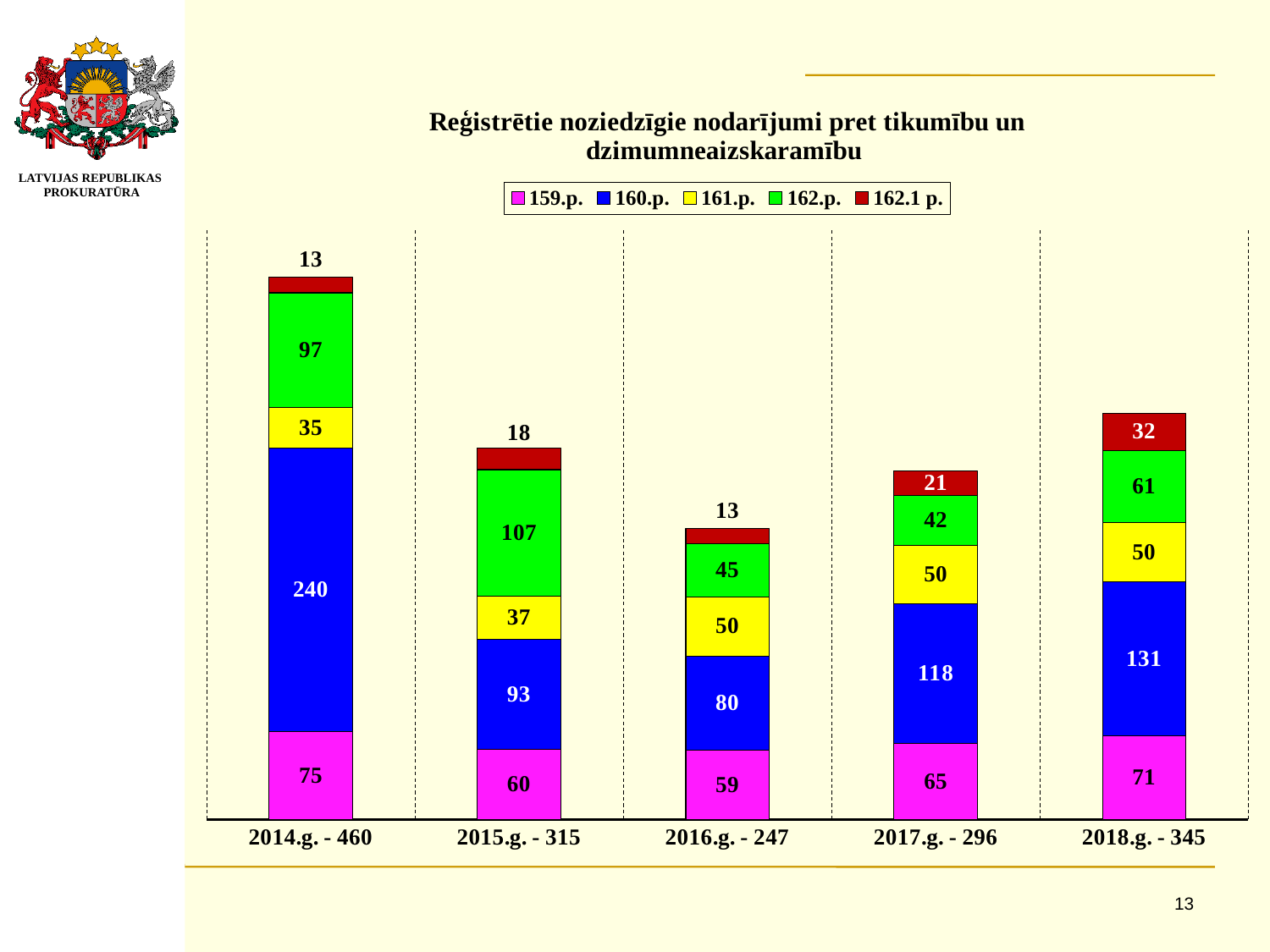
What is the value for 162.p. in 2015? 107 What type of chart is shown on the slide? stacked bar chart What is the value for 159.p. in 2016? 59 How many years (categories) are shown on the x axis? 5 Which year has the lowest total of registered offences? 2016 What is the total of the stacked bar for 2017? 296 What is the value for 162.1 p. in 2018? 32 What is the difference between the 160.p. values for 2018 and 2017? 13 How many series does the legend list? 5 What is the value for 160.p. in 2014? 240 Which year has the highest total of registered offences? 2014 Which is larger, the 162.p. value in 2016 or the 162.p. value in 2018? 2018